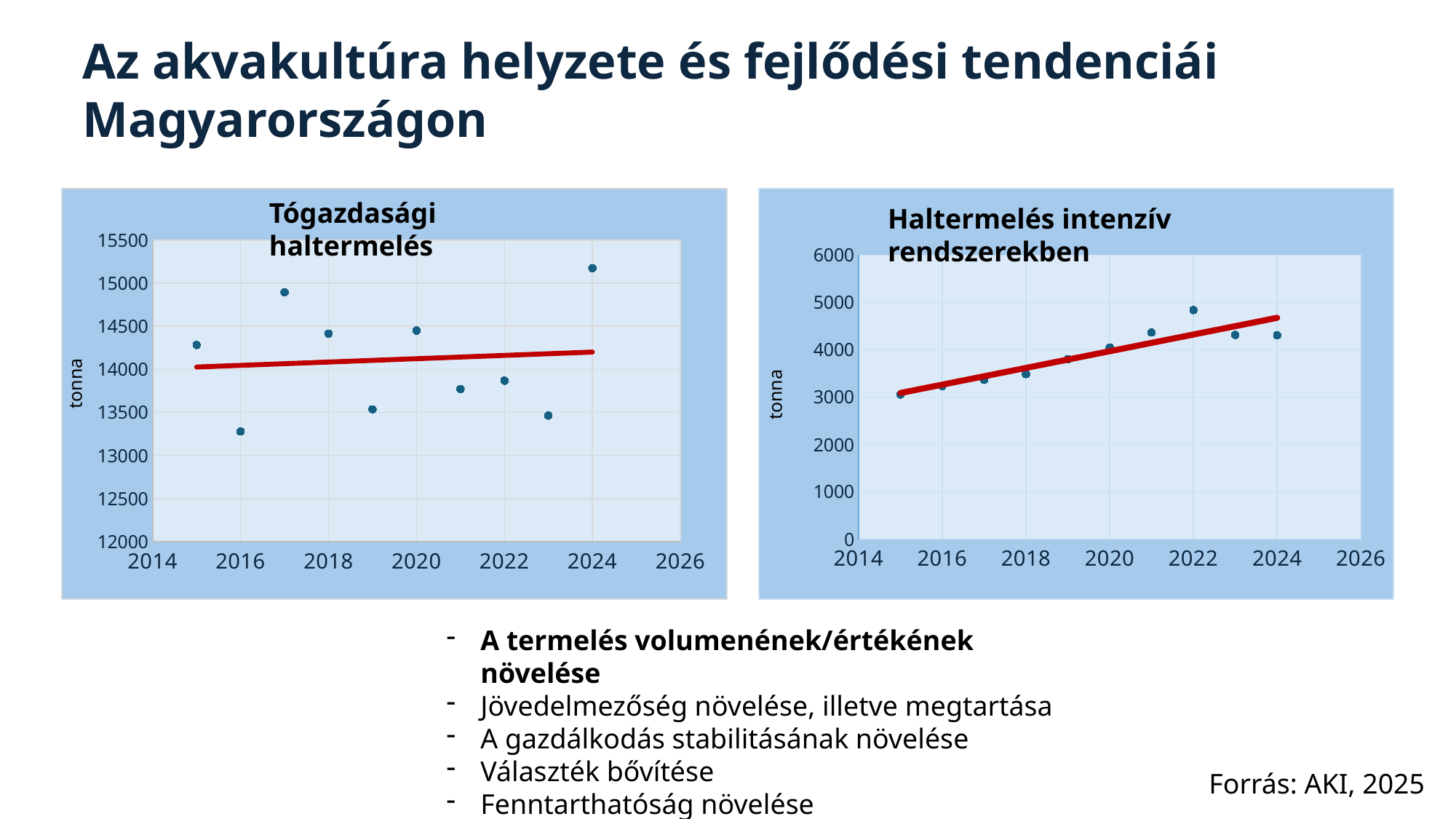
In the 'Haltermelés intenzív rendszerekben' chart, which year has the highest value? 2022 What kind of chart is the 'Tógazdasági haltermelés' chart? scatter chart What unit is shown on the vertical axis of the 'Haltermelés intenzív rendszerekben' chart? tonna In the 'Haltermelés intenzív rendszerekben' chart, which is larger, the value for 2022 or the value for 2015? 2022 In the 'Tógazdasági haltermelés' chart, is the value for 2021 greater or less than 14000? less In the 'Tógazdasági haltermelés' chart, which year has the highest value? 2024 In the 'Haltermelés intenzív rendszerekben' chart, is the value for 2019 greater or less than 4000? less How many data points are plotted in the 'Tógazdasági haltermelés' chart? 10 In the 'Haltermelés intenzív rendszerekben' chart, which year has the lowest value? 2015 In the 'Tógazdasági haltermelés' chart, is the value for 2024 greater or less than 15000? greater In the 'Haltermelés intenzív rendszerekben' chart, do the values generally rise or fall from 2015 to 2022? rise In the 'Tógazdasági haltermelés' chart, which year has the lowest value? 2016